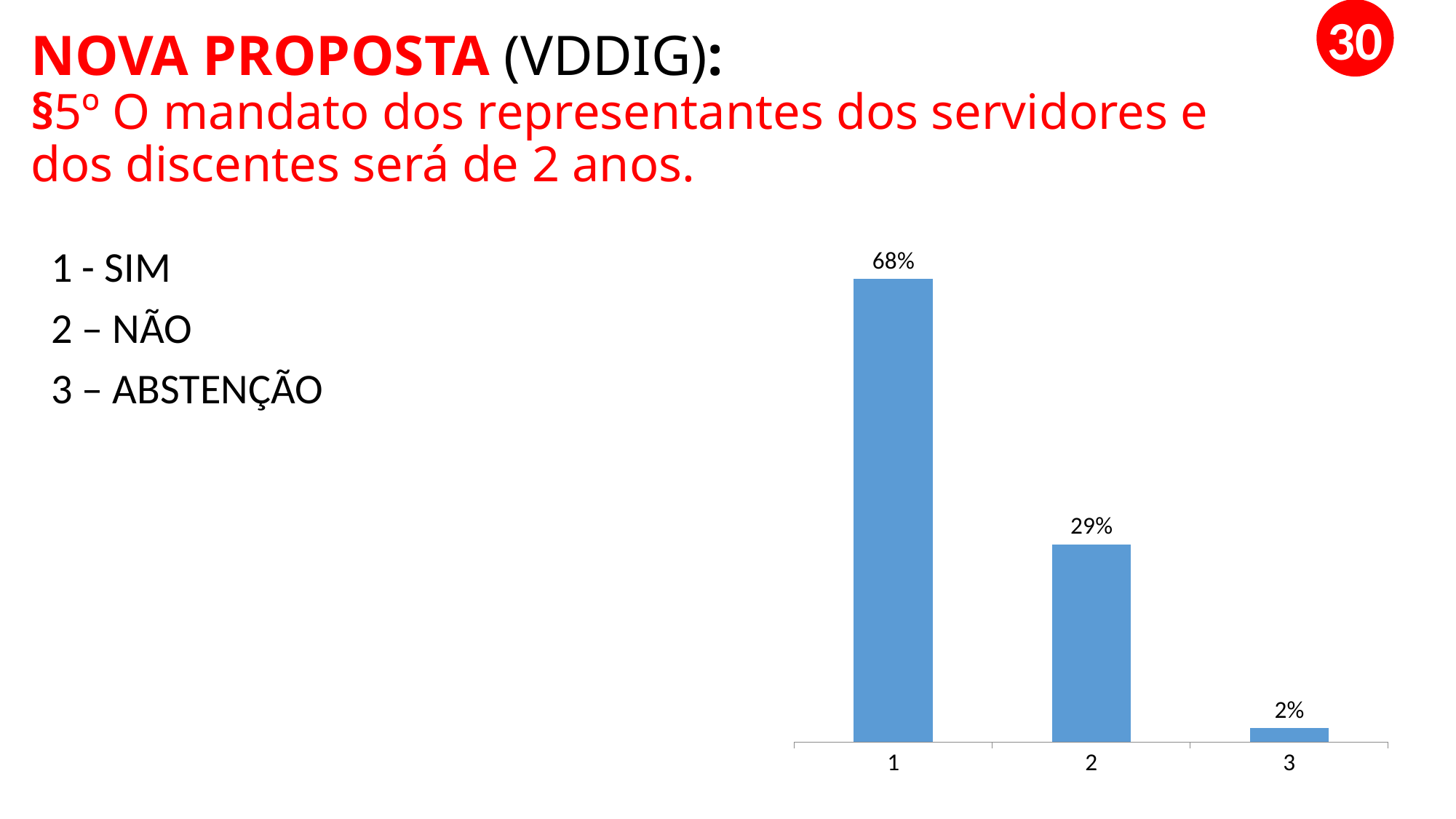
Which category has the lowest value in the bar chart? 3 What is the value for category 3 in the bar chart? 2% Do the values rise or fall from category 1 to category 3? fall What is the difference between the values for category 1 and category 2? 39% What is the value for category 2 in the bar chart? 29% Which category has the highest value in the bar chart? 1 What is the difference between the values for category 2 and category 3? 27% Which is larger, the value for category 2 or the value for category 3? 2 What is the value for category 1 in the bar chart? 68% According to the slide's key, what does category 1 in the chart stand for? SIM How many categories are shown in the bar chart? 3 What kind of chart is shown on the slide? bar chart